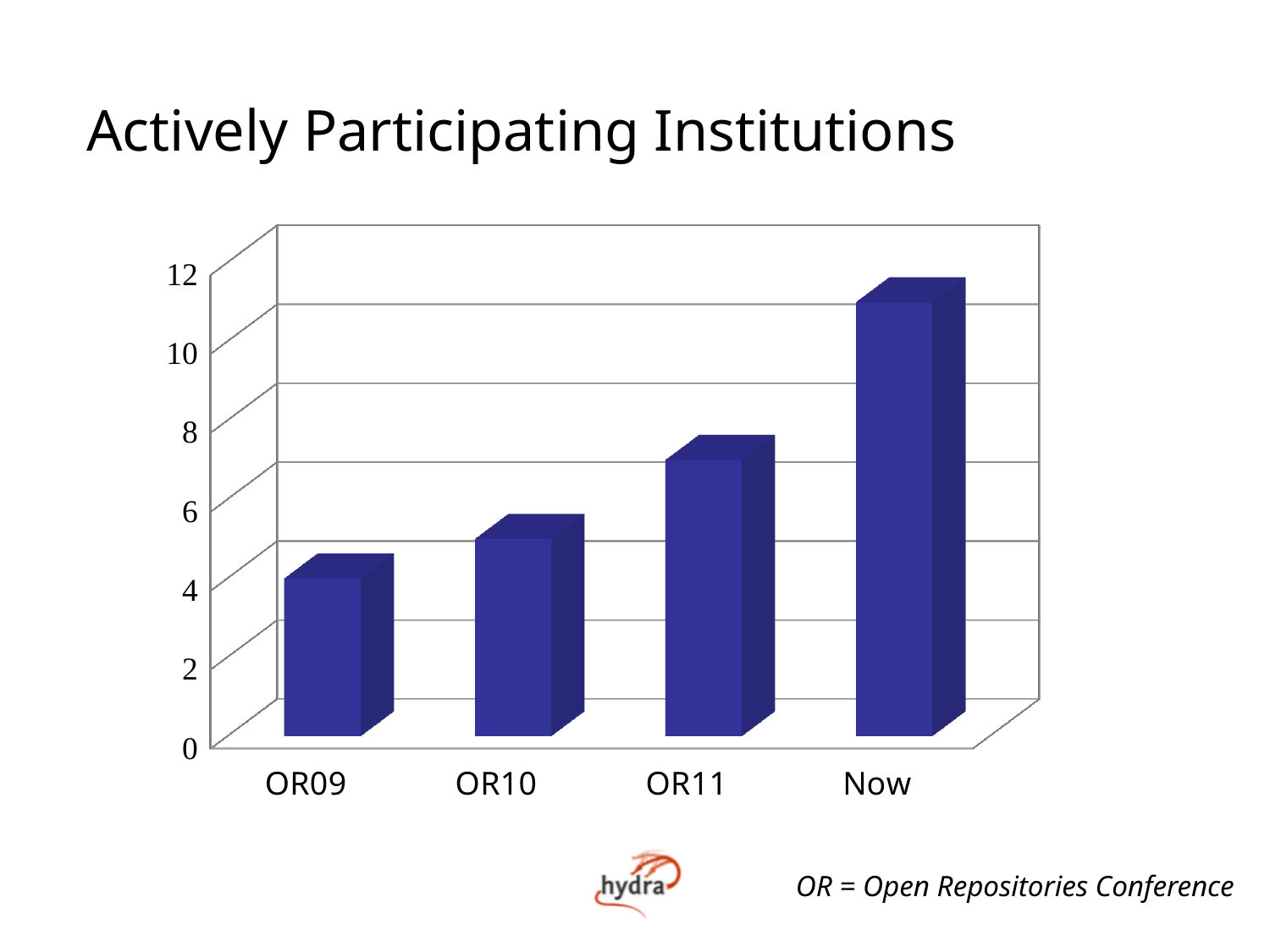
How many categories are shown on the x axis? 4 Which category has the highest value? Now What type of chart is shown on the slide? bar chart Is the value for Now greater or less than 8? greater Is the value for OR09 greater or less than 6? less Is the value for OR11 greater or less than 10? less What is the title of the chart? Actively Participating Institutions Which is larger, the value for OR11 or the value for OR10? OR11 Which is larger, the value for OR09 or the value for Now? Now Which category has the lowest value? OR09 Do the values rise or fall from OR09 to Now? rise